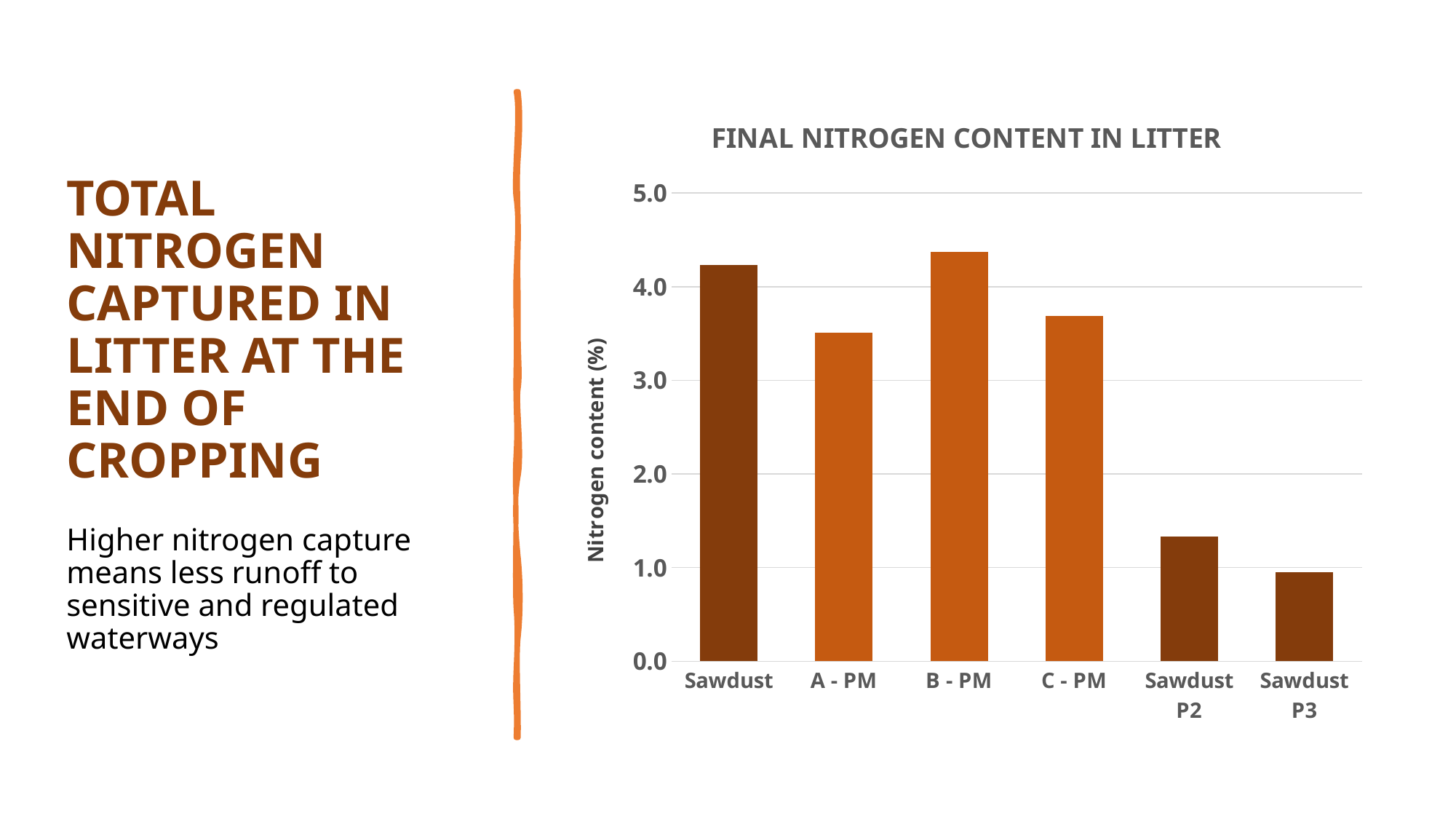
How many categories are shown on the x axis of the chart? 6 Is the value for A - PM greater or less than 3.0? greater Which category has the lowest nitrogen content? Sawdust P3 Is the value for Sawdust P2 greater or less than 1.0? greater Is the value for C - PM greater or less than 4.0? less What is the label on the y axis of the chart? Nitrogen content (%) Which has a higher nitrogen content, A - PM or C - PM? C - PM What is the title of the chart? FINAL NITROGEN CONTENT IN LITTER Which category has the highest nitrogen content? B - PM What kind of chart is shown on the slide? bar chart